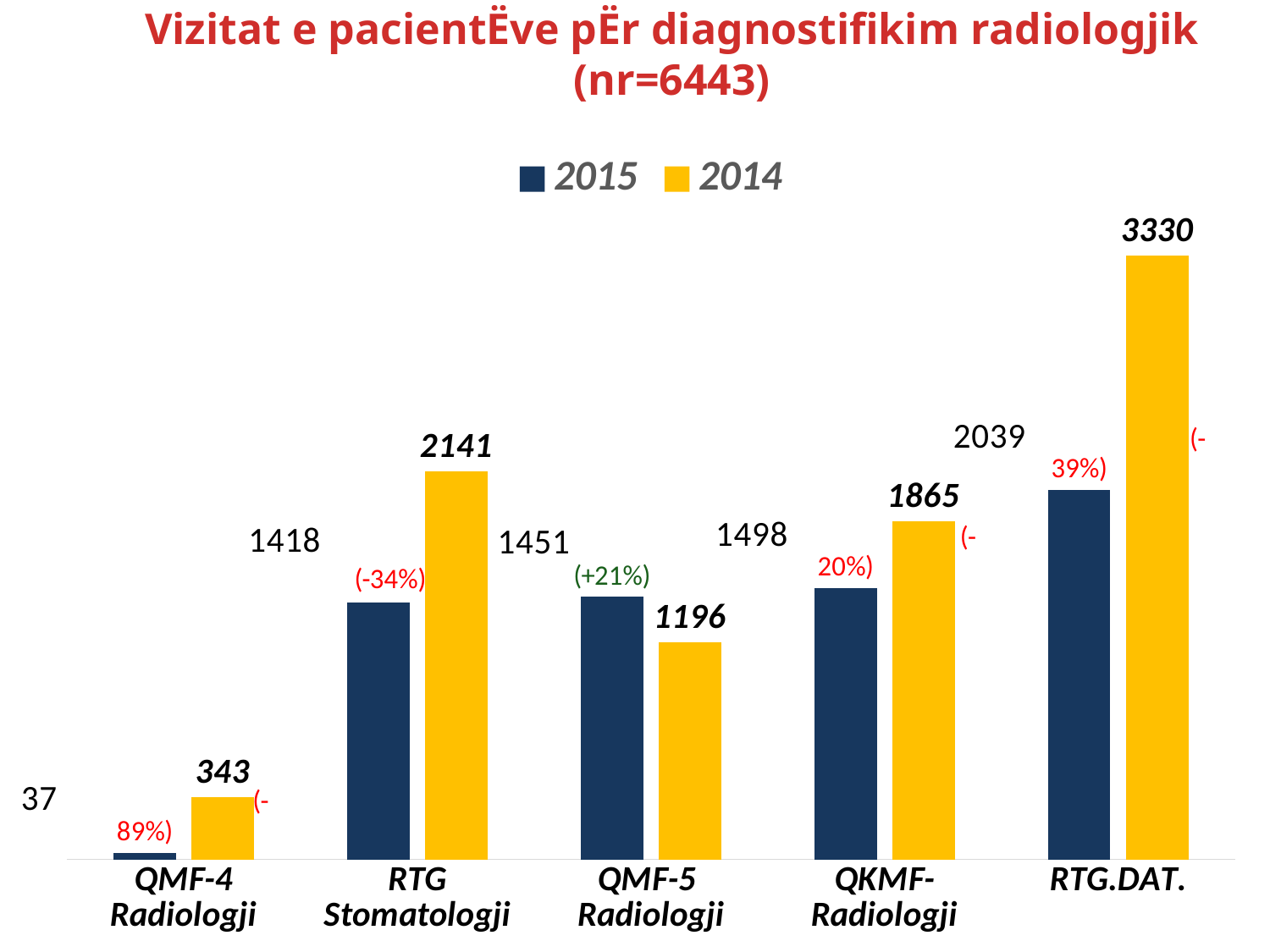
What is the difference between the 2014 values for RTG.DAT. and QKMF-Radiologji? 1465 Which category has the highest 2014 value? RTG.DAT. What is the 2014 value for QMF-4 Radiologji? 343 What is the 2014 value for RTG.DAT.? 3330 What is the 2014 value for RTG Stomatologji? 2141 How many categories are shown on the x axis? 5 What is the 2014 value for QMF-5 Radiologji? 1196 How many series does the legend list? 2 What type of chart is shown on the slide? bar chart Which category has the lowest 2014 value? QMF-4 Radiologji What percentage change is shown for QMF-5 Radiologji? +21% For QMF-5 Radiologji, which series has the larger value, 2015 or 2014? 2015